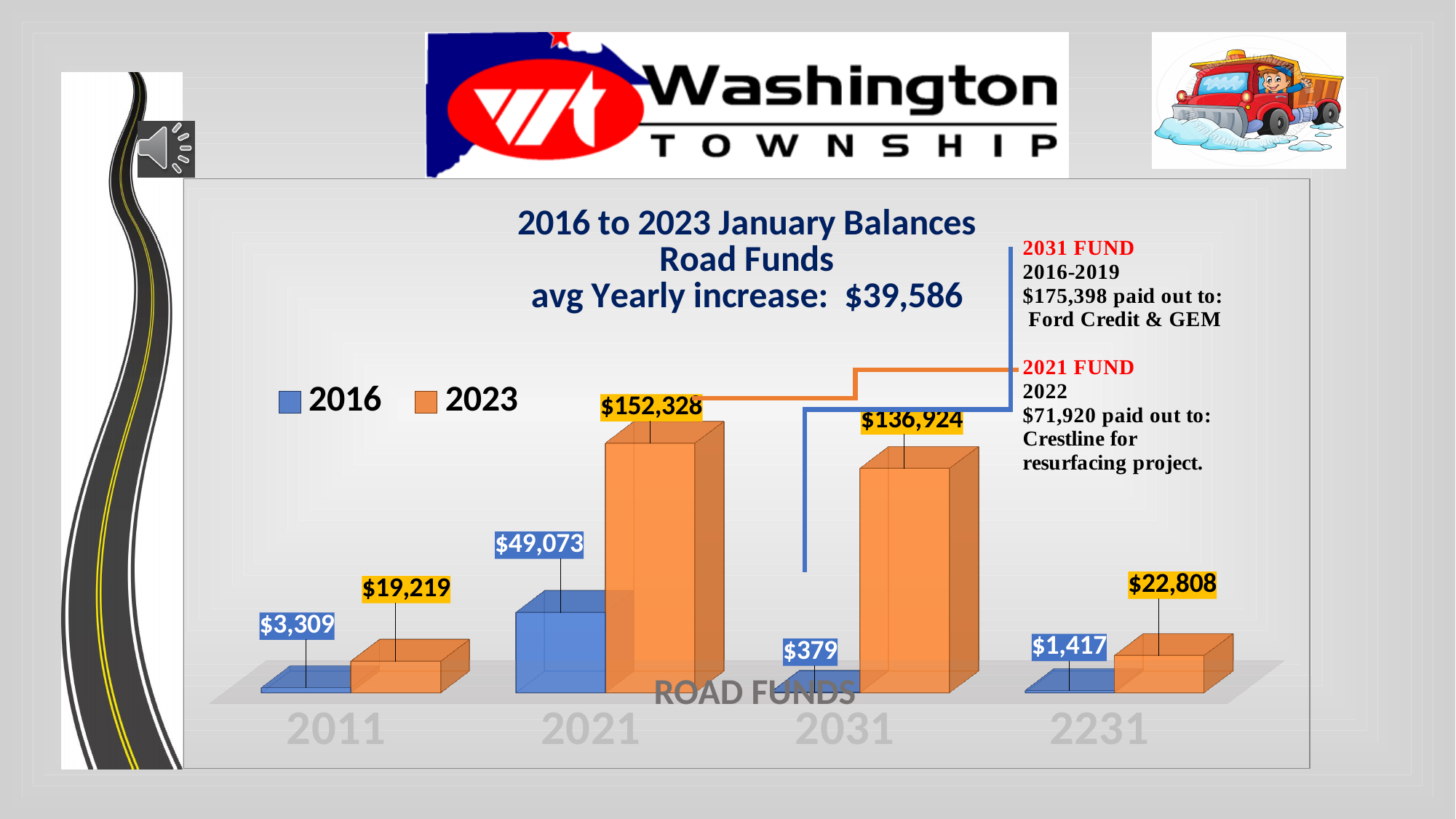
How many series does the legend list? 2 What kind of chart is shown? Bar chart What average yearly increase is stated in the chart title? $39,586 What is the 2023 value for the 2231 fund? $22,808 What is the difference between the 2023 and 2016 values for the 2021 fund? $103,255 Which fund has the lowest 2016 balance? 2031 Which fund has the highest 2023 balance? 2021 Which is larger, the 2023 value for the 2011 fund or the 2023 value for the 2231 fund? 2231 fund What is the 2016 value for the 2031 fund? $379 What is the 2023 value for the 2021 fund? $152,328 How many fund categories are shown on the x axis? 4 What is the 2016 value for the 2011 fund? $3,309